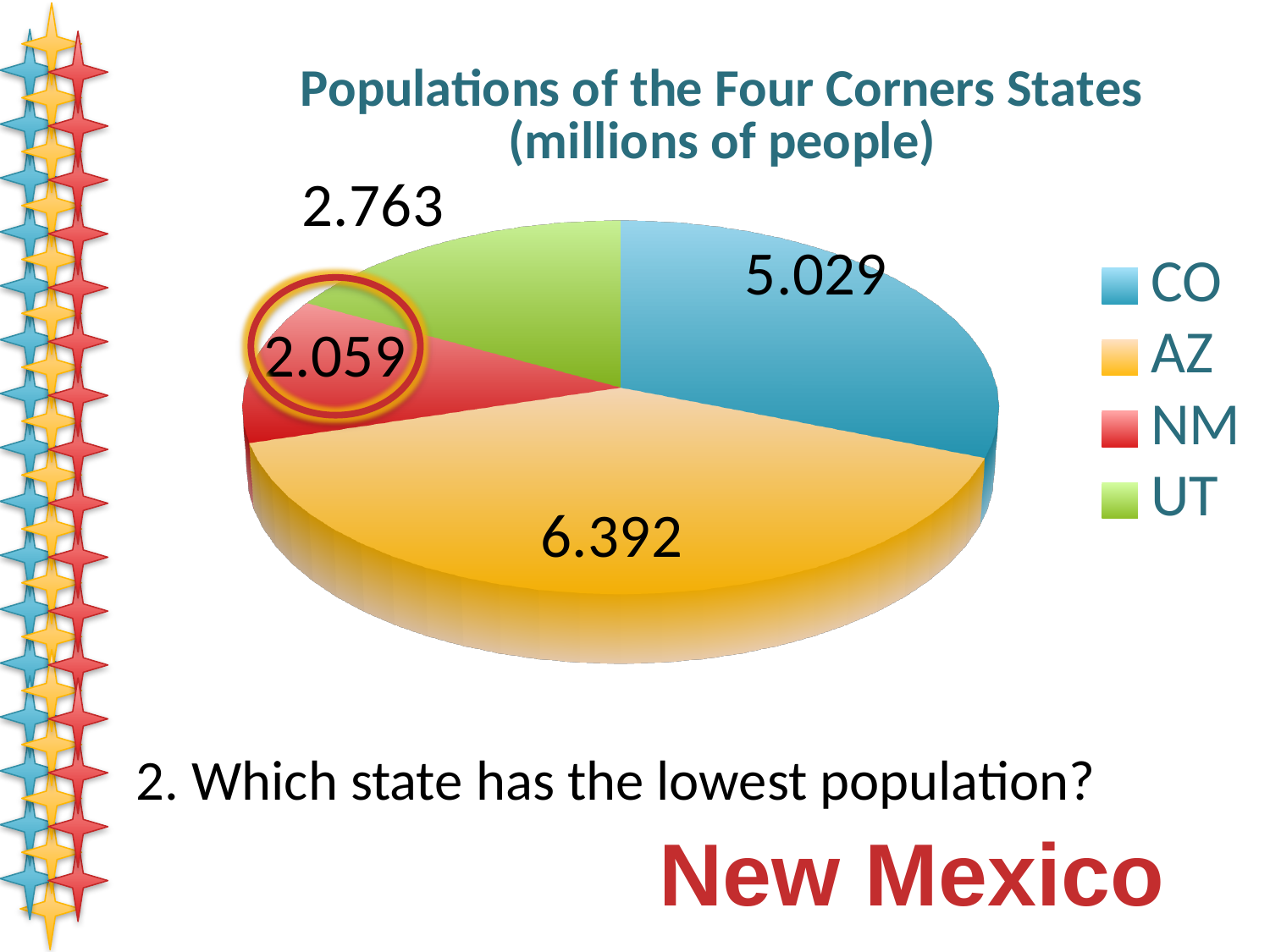
What is the difference between the values for CO and UT? 2.266 What is the difference between the values for AZ and NM? 4.333 What kind of chart is shown on the slide? Pie chart What is the title of the chart? Populations of the Four Corners States (millions of people) How many states are shown in the pie chart? 4 Which state has the largest slice of the pie? AZ What is the population value shown for CO? 5.029 What is the population value shown for UT? 2.763 What is the population value shown for NM? 2.059 Which state has the smallest slice of the pie? NM What is the population value shown for AZ? 6.392 Which is larger, the value for CO or the value for UT? CO